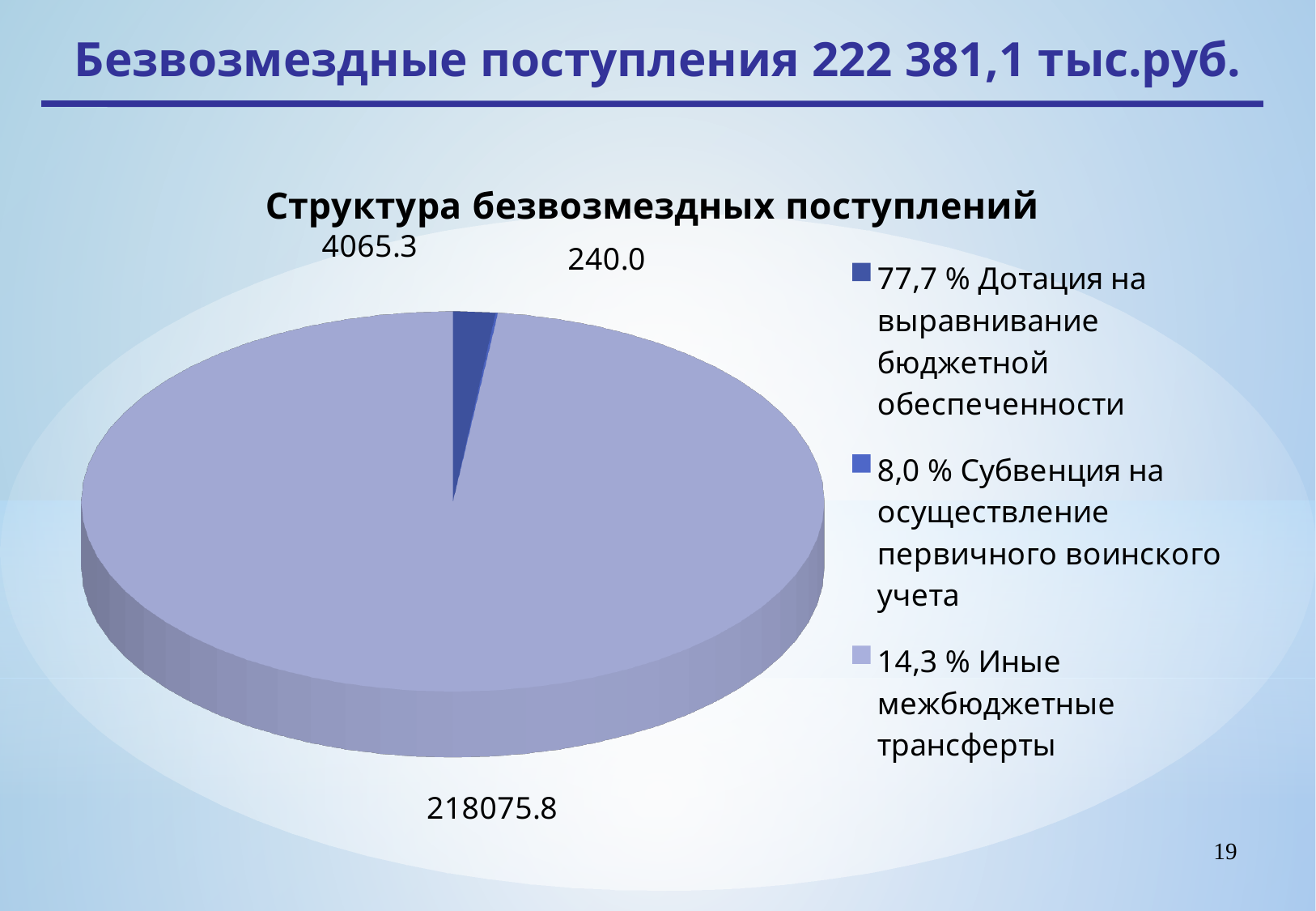
What is the smallest value labelled on the pie chart? 240.0 According to the legend, what share is given for Иные межбюджетные трансферты? 14,3 % How many entries does the legend list? 3 What is the difference between the values 4065.3 and 240.0 labelled on the pie chart? 3825.3 According to the legend, what share is given for Дотация на выравнивание бюджетной обеспеченности? 77,7 % Which is larger, the slice labelled 4065.3 or the slice labelled 240.0? 4065.3 What is the total of the three values labelled on the pie chart? 222381.1 What kind of chart is shown on the slide? Pie chart How many slices does the pie chart have? 3 What is the title of the chart? Структура безвозмездных поступлений What is the largest value labelled on the pie chart? 218075.8 According to the legend, what share is given for Субвенция на осуществление первичного воинского учета? 8,0 %